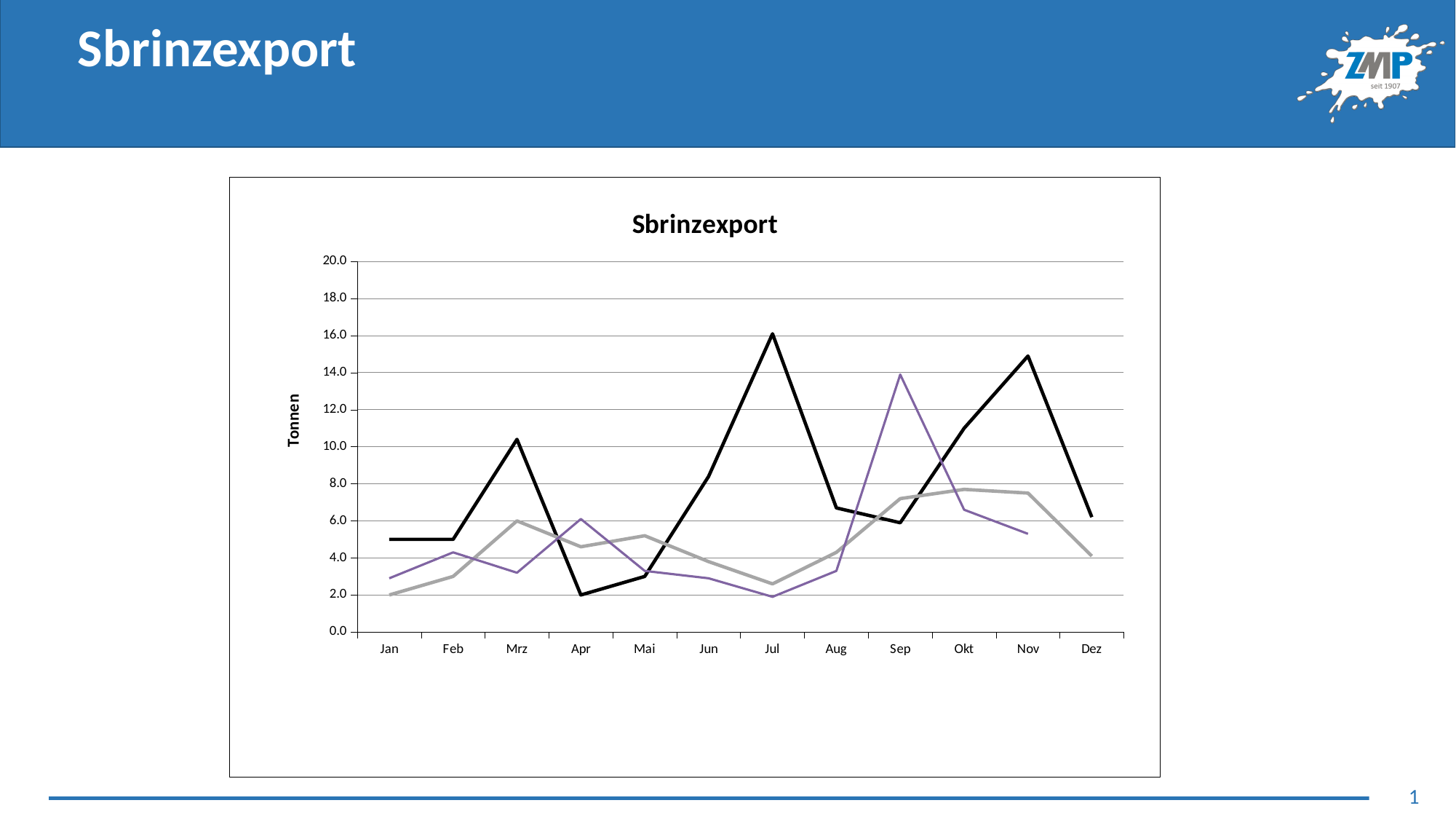
Does the black line rise or fall from Jul to Aug? fall What kind of chart is shown on the slide? line chart In which month does the black line reach its lowest value? Apr What is the label on the vertical axis of the chart? Tonnen Is the value of the black line in Apr greater or less than 4.0? less In Jul, which line has the higher value, the black line or the grey line? the black line In which month does the black line reach its highest value? Jul How many months are shown on the x axis of the chart? 12 Is the value of the black line in Jul greater or less than 14.0? greater What is the title of the chart? Sbrinzexport How many lines are plotted in the chart? 3 In which month does the purple line reach its highest value? Sep